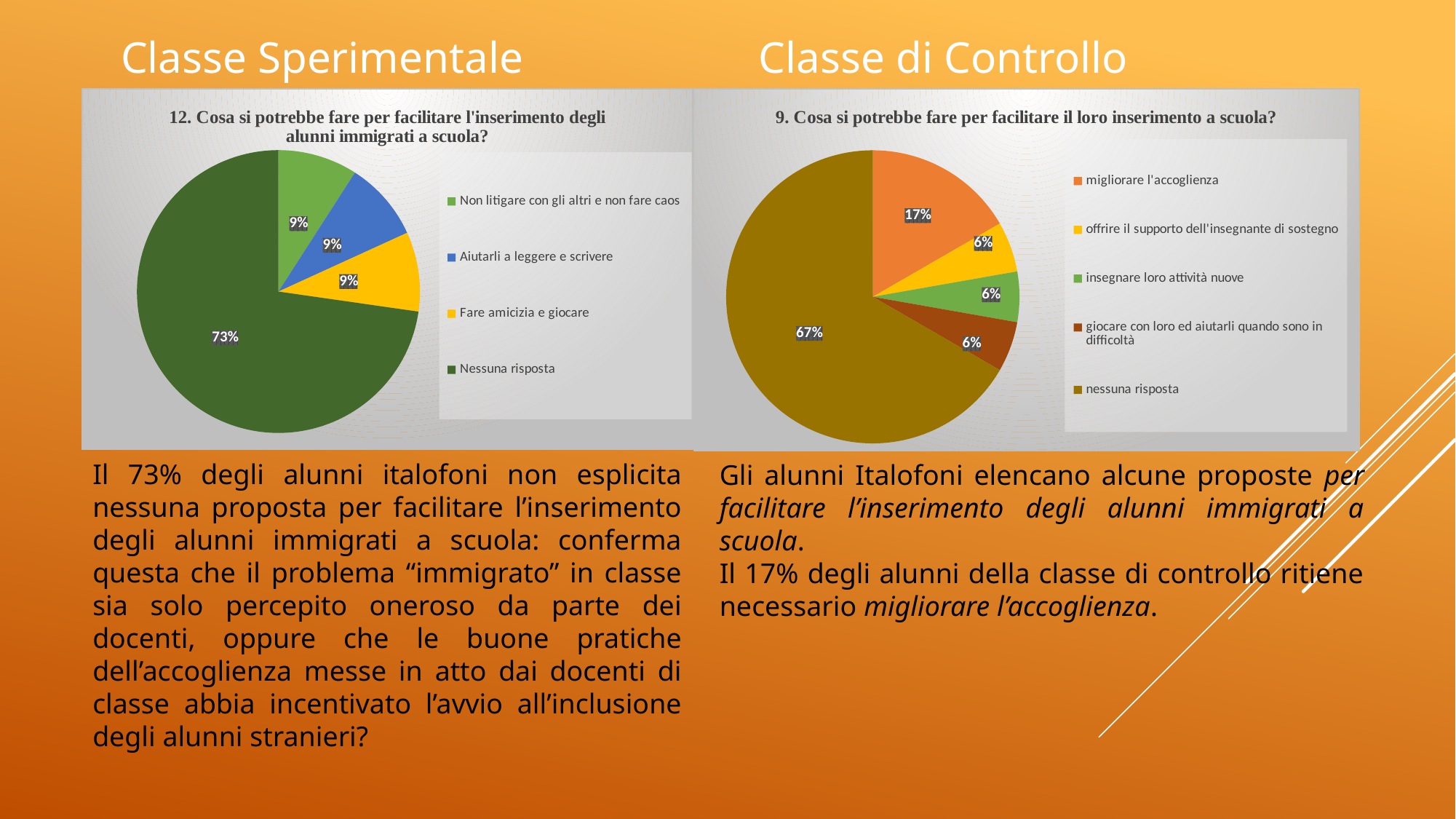
Which chart has the larger 'nessuna risposta' share, the left (Classe Sperimentale) or the right (Classe di Controllo)? Left (Classe Sperimentale) In the right chart (Classe di Controllo), how many categories does the legend list? 5 In the left chart (Classe Sperimentale), what share of the pie is 'Nessuna risposta'? 73% What kind of chart is shown under 'Classe di Controllo'? Pie chart In the left chart (Classe Sperimentale), which category has the largest slice? Nessuna risposta In the left chart (Classe Sperimentale), what is the difference between 'Nessuna risposta' and 'Fare amicizia e giocare'? 64% In the right chart (Classe di Controllo), what share of the pie is 'migliorare l'accoglienza'? 17% In the left chart (Classe Sperimentale), how many categories does the legend list? 4 In the right chart (Classe di Controllo), which is larger: 'migliorare l'accoglienza' or 'insegnare loro attività nuove'? migliorare l'accoglienza In the left chart (Classe Sperimentale), what share of the pie is 'Aiutarli a leggere e scrivere'? 9% In the right chart (Classe di Controllo), what share of the pie is 'nessuna risposta'? 67% In the right chart (Classe di Controllo), which category has the largest slice? nessuna risposta